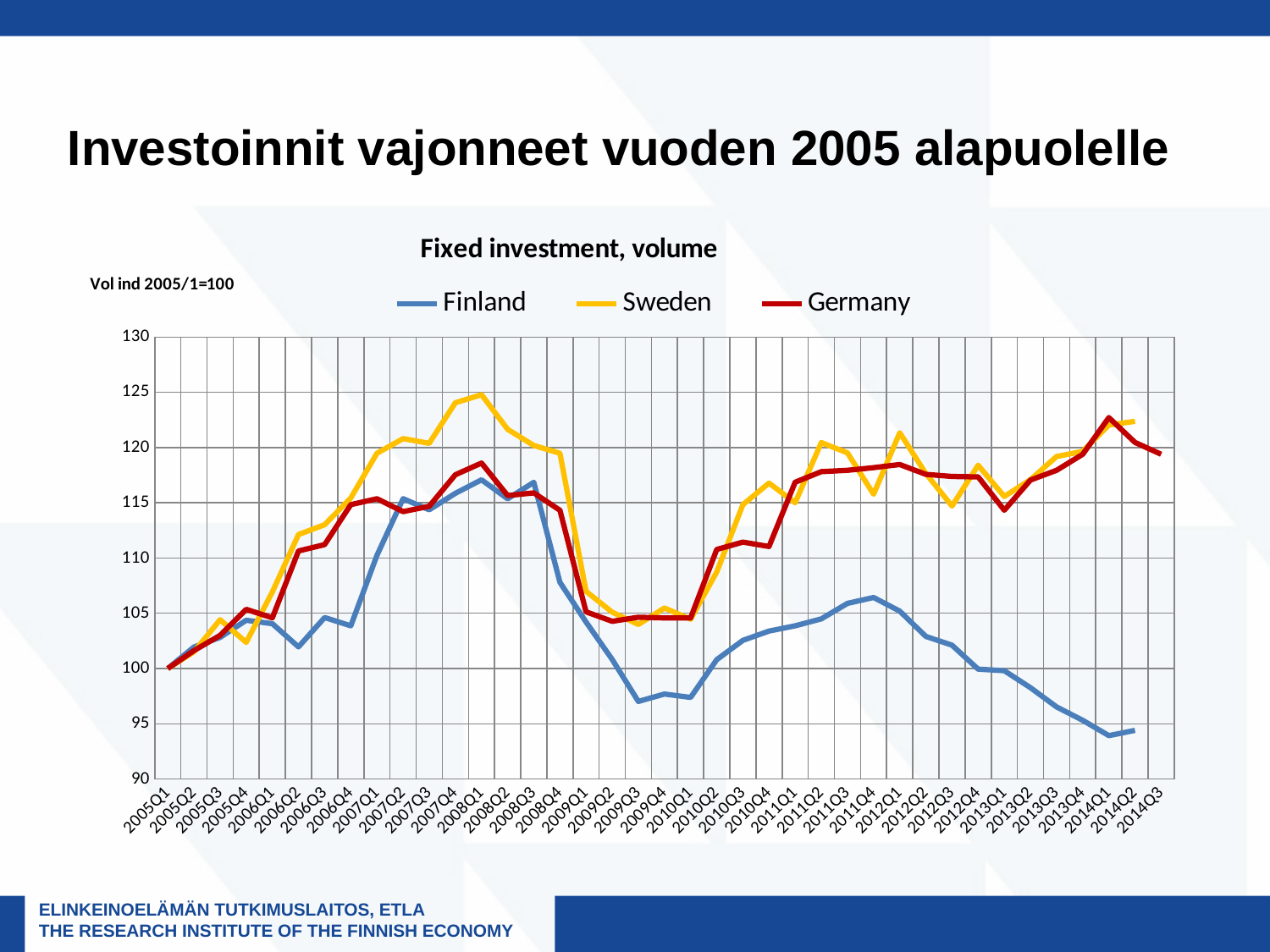
Is the value for Finland at 2014Q2 greater or less than 95? less How many series does the legend list? 3 At 2014Q2, which is larger, the value for Sweden or the value for Finland? Sweden What is the title of the chart? Fixed investment, volume What is the value for Finland at 2005Q1? 100 Is the value for Sweden at 2008Q1 greater or less than 120? greater Which series has the lowest value at 2014Q2? Finland Which series has the highest value at 2008Q1? Sweden Does the Finland line rise or fall from 2011Q4 to 2014Q2? fall What kind of chart is shown on the slide? line chart What colour is the Finland line? blue Is the value for Finland at 2009Q3 greater or less than 100? less